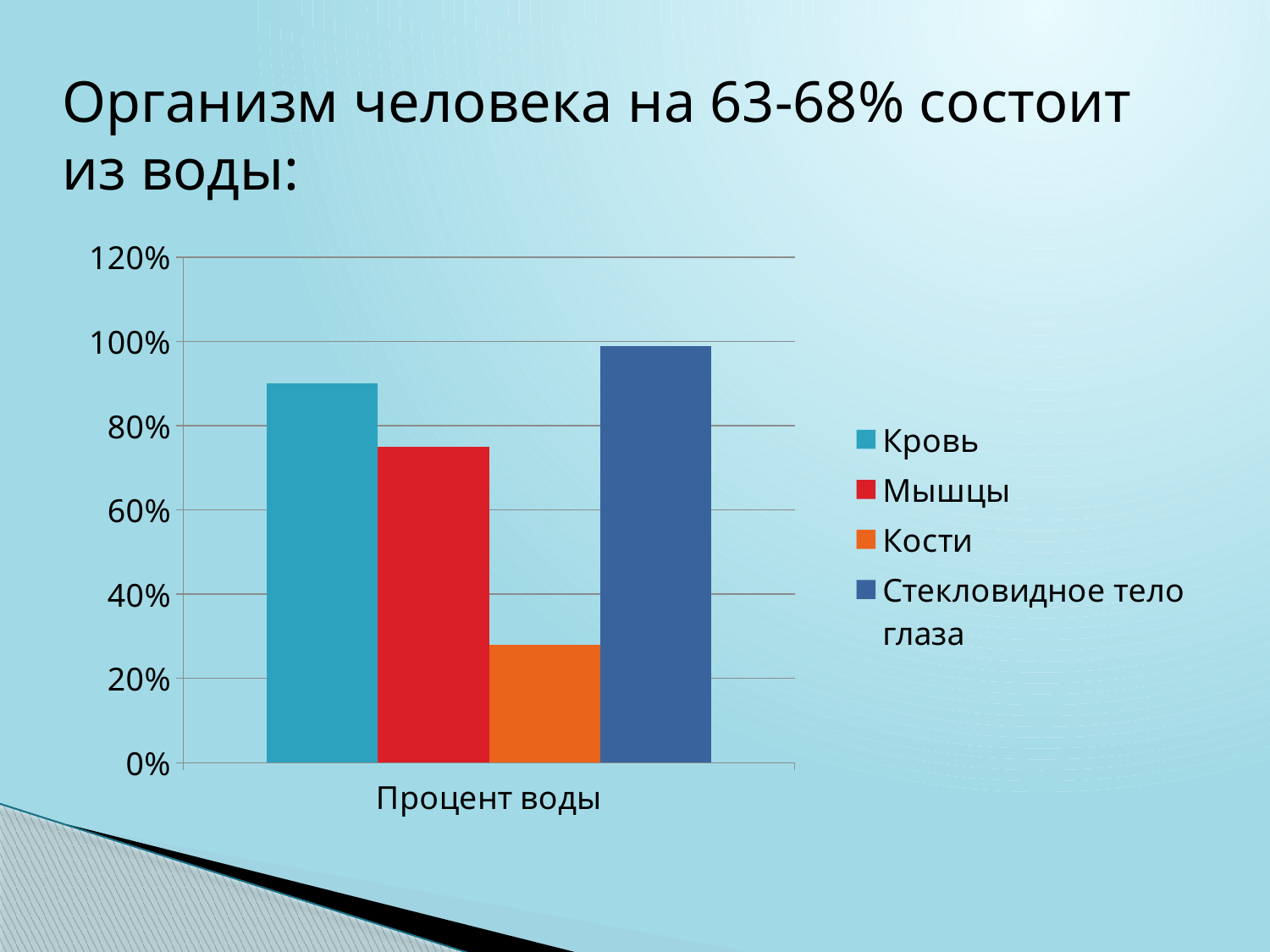
Which is larger, the value for Кровь or the value for Мышцы? Кровь Which is larger, the value for Кости or the value for Мышцы? Мышцы What colour is the bar for Кости? orange Is the value for Кровь greater or less than 80%? greater How many series does the legend list? 4 Is the value for Мышцы greater or less than 80%? less Is the value for Стекловидное тело глаза greater or less than 80%? greater Which series has the highest value? Стекловидное тело глаза What kind of chart is shown on the slide? bar chart Which series has the lowest value? Кости What is the category label shown on the x axis? Процент воды